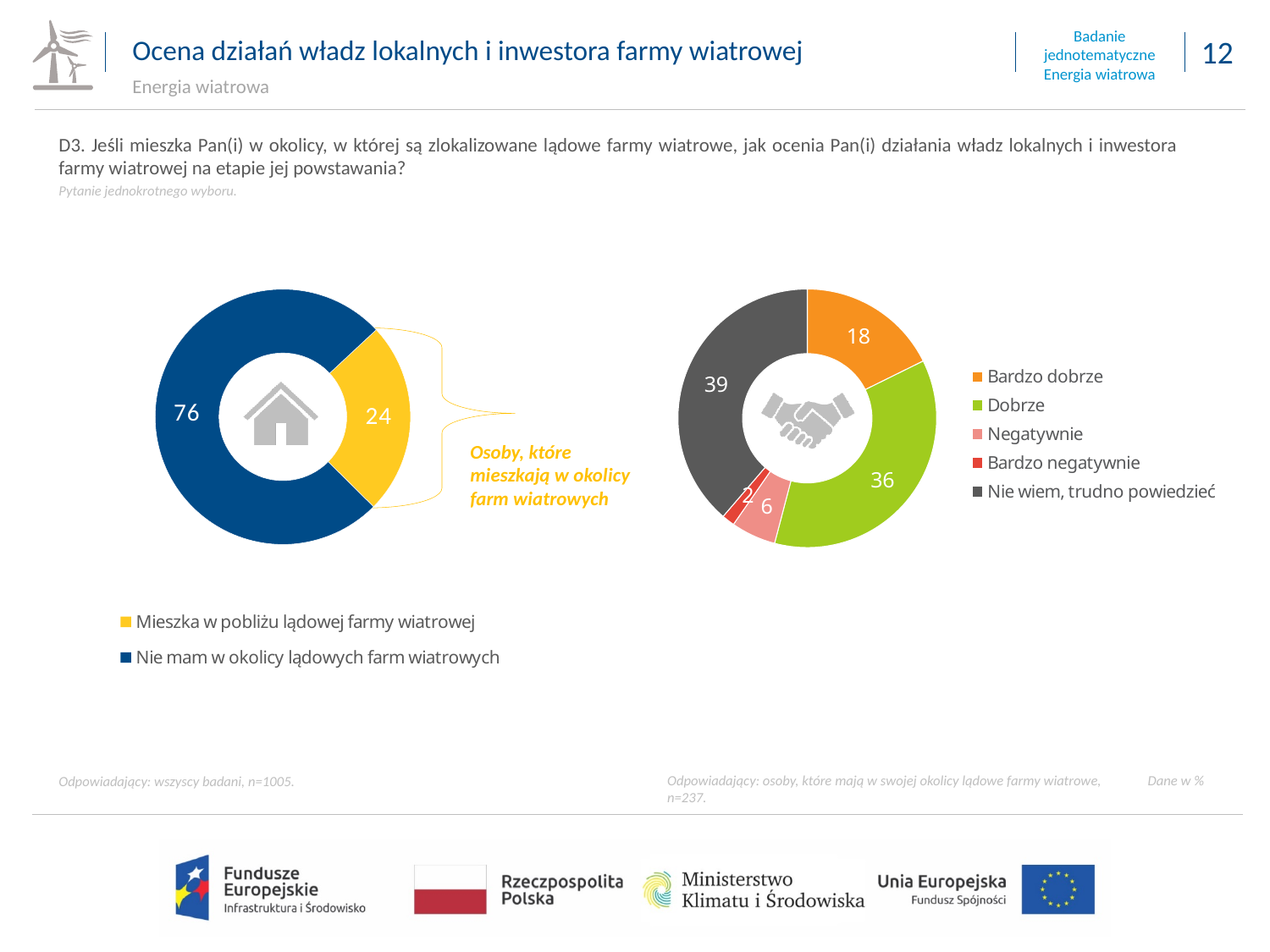
In the right donut chart, which is larger: "Bardzo dobrze" or "Negatywnie"? Bardzo dobrze In the left donut chart, what is the difference between the two slices? 52 In the right donut chart, what is the difference between "Nie wiem, trudno powiedzieć" and "Bardzo dobrze"? 21 In the left donut chart, what is the value for "Mieszka w pobliżu lądowej farmy wiatrowej"? 24 In the right donut chart, what is the value for "Dobrze"? 36 In the right donut chart, what is the value for "Bardzo negatywnie"? 2 In the right donut chart, which category has the highest value? Nie wiem, trudno powiedzieć In the right donut chart, which category has the lowest value? Bardzo negatywnie What type of chart is the left chart? Donut (pie) chart In the left donut chart, what is the value for "Nie mam w okolicy lądowych farm wiatrowych"? 76 In the right donut chart, what colour is the "Dobrze" slice? Green How many categories does the legend of the right donut chart list? 5